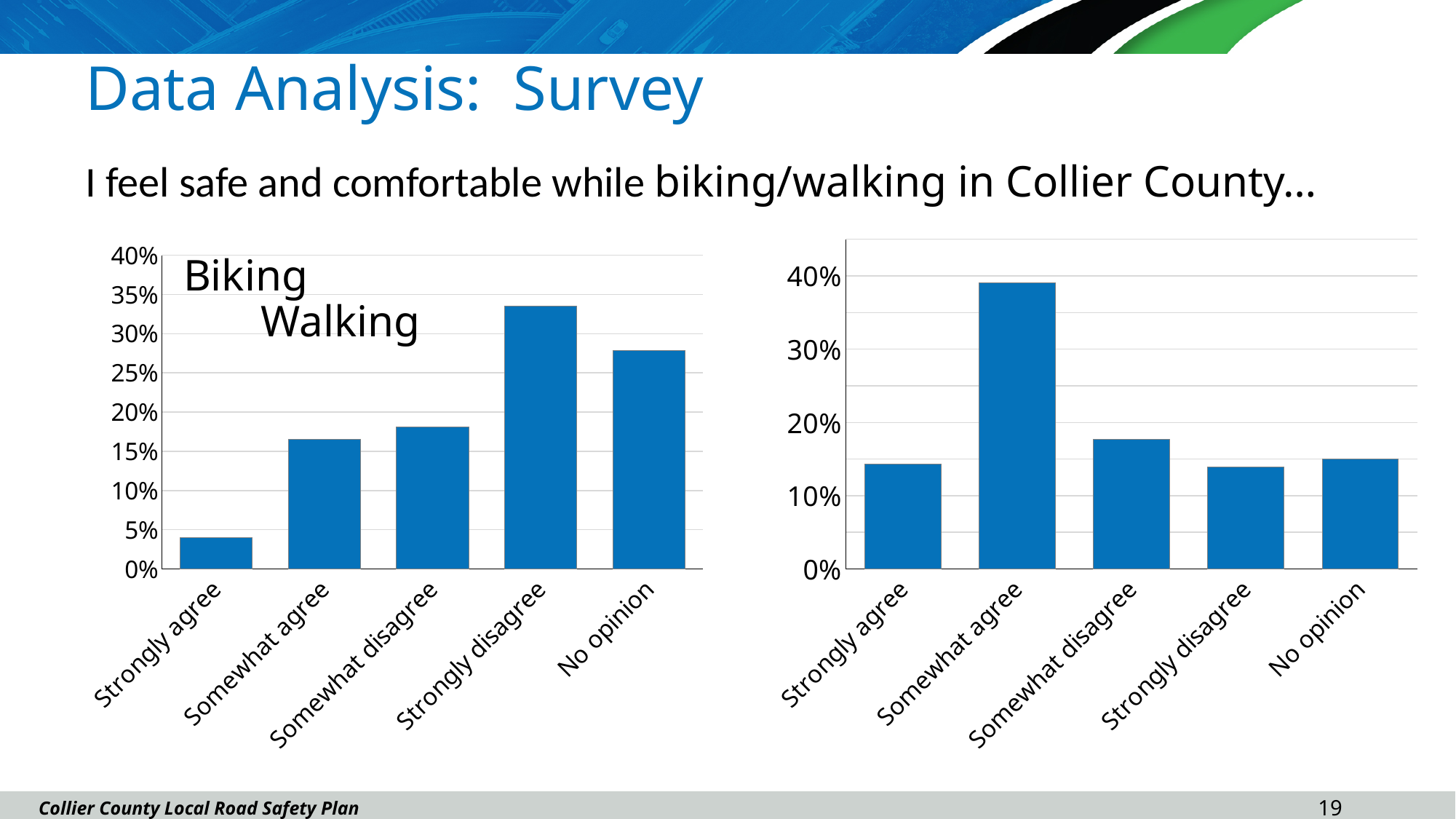
In the right chart, which is larger: Somewhat agree or Strongly agree? Somewhat agree In the left chart, which category has the highest value? Strongly disagree In the left chart, which category has the lowest value? Strongly agree In the left chart, is the value for Strongly disagree greater or less than 30%? greater In the left chart, is the value for Strongly agree greater or less than 5%? less In the left chart, which is larger: No opinion or Somewhat agree? No opinion What is the highest tick value shown on the y axis of the left chart? 40% How many categories are shown on the x axis of the right chart? 5 What kind of chart is the left chart? Bar chart In the right chart, which category has the highest value? Somewhat agree In the right chart, is the value for Somewhat disagree greater or less than 20%? less